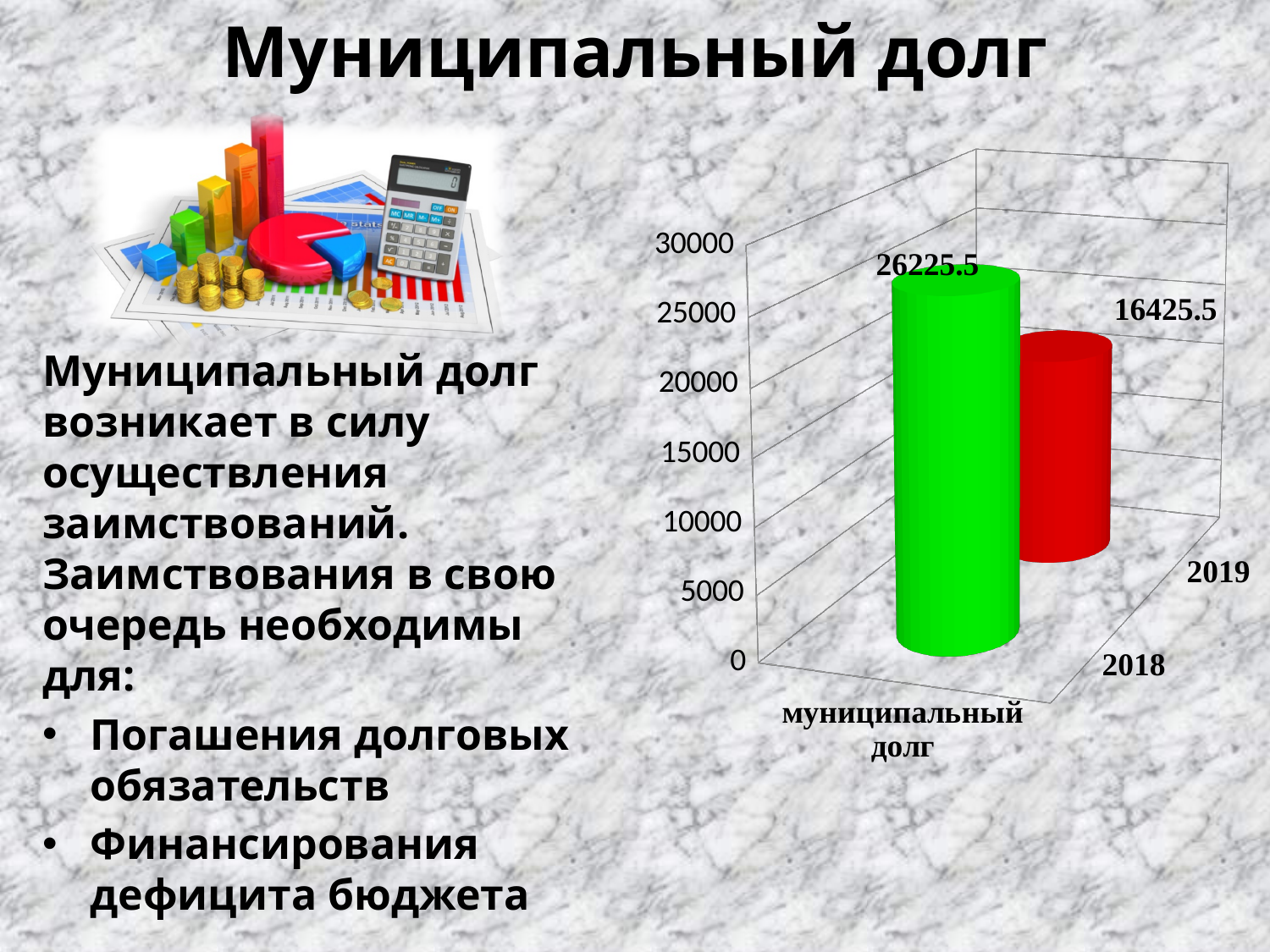
What kind of chart is shown on the slide? bar chart Is the municipal debt value for 2019 greater or less than 20000? less Which year has the highest municipal debt value on the chart? 2018 Which year has the lowest municipal debt value on the chart? 2019 Does the municipal debt rise or fall from 2018 to 2019? fall What colour is the bar for 2019? red By how much does the municipal debt in 2018 exceed the municipal debt in 2019? 9800 Which year shows the higher municipal debt, 2018 or 2019? 2018 What is the value of the municipal debt (муниципальный долг) for 2019? 16425.5 Is the municipal debt value for 2018 greater or less than 25000? greater What is the value of the municipal debt (муниципальный долг) for 2018? 26225.5 How many bars are plotted on the chart? 2